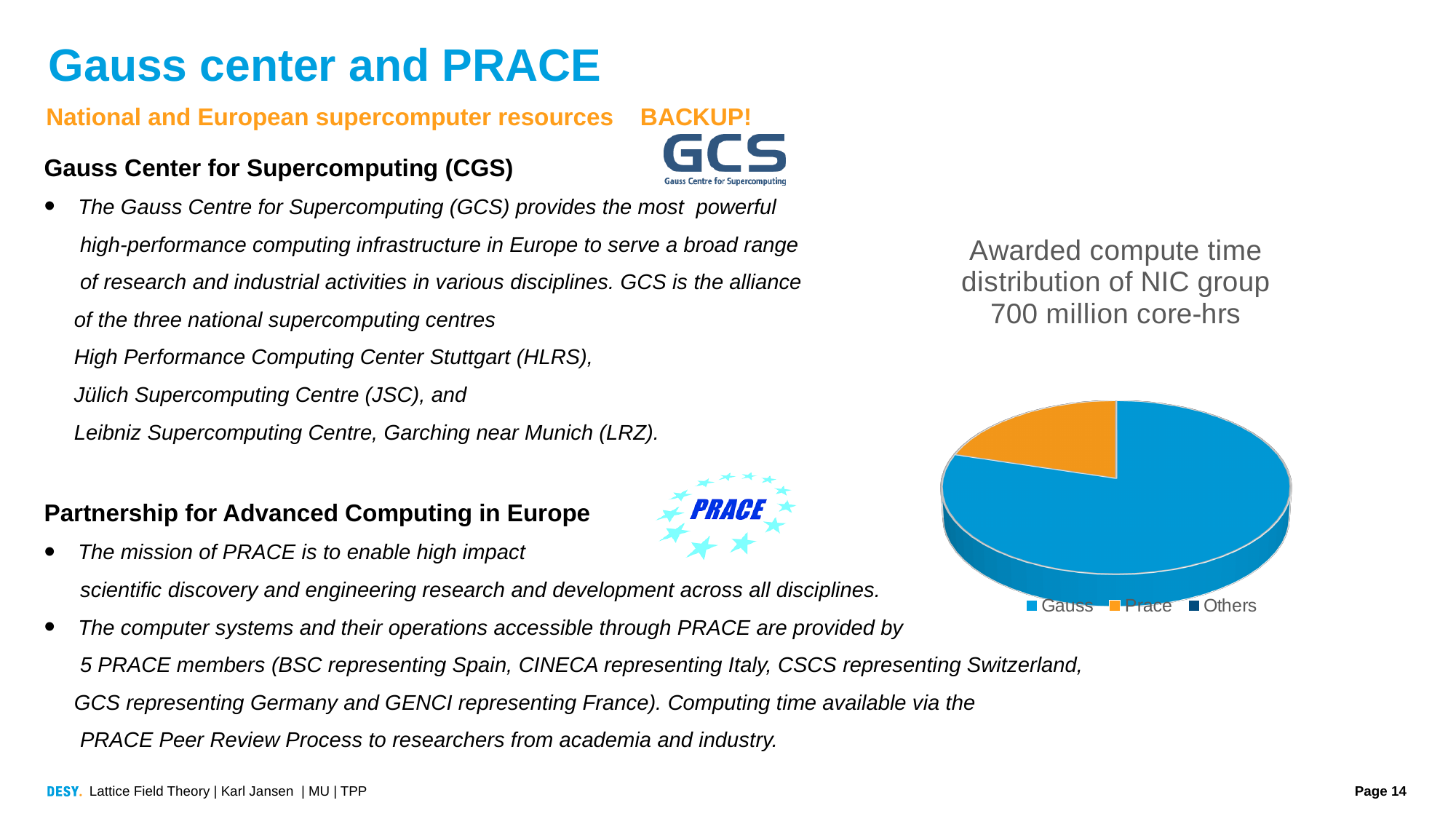
What is the title of the pie chart? Awarded compute time distribution of NIC group 700 million core-hrs How many entries does the legend of the pie chart list? 3 Which is smaller in the pie chart, Prace or Gauss? Prace Which category has the largest slice of the pie chart? Gauss What colour is the Prace slice in the pie chart? orange Which is larger in the pie chart, the Gauss slice or the Prace slice? Gauss What kind of chart is shown on the slide? pie chart